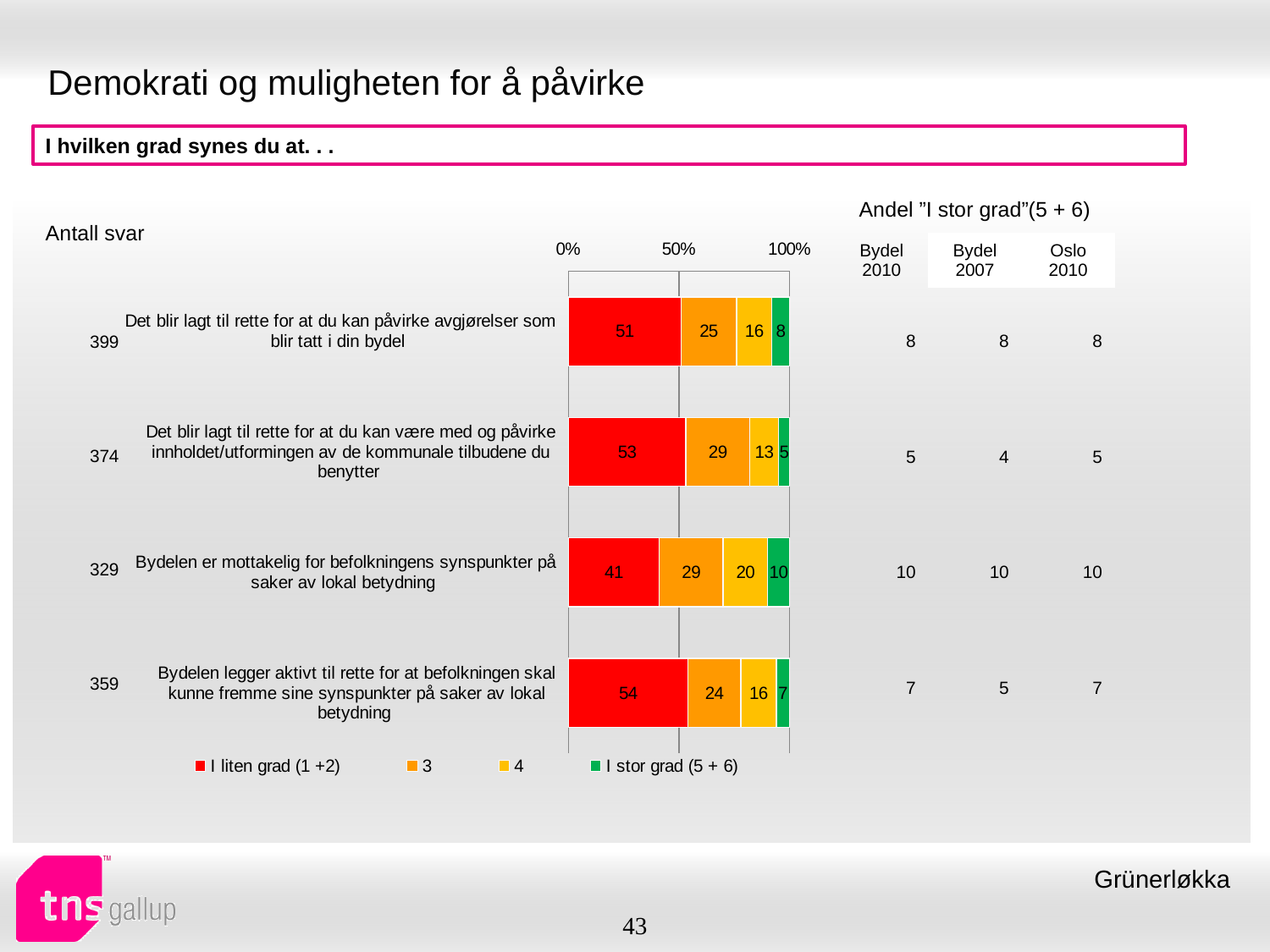
Which statement has the highest 'I liten grad (1 +2)' value? Bydelen legger aktivt til rette for at befolkningen skal kunne fremme sine synspunkter på saker av lokal betydning What is the value of 'I stor grad (5 + 6)' for 'Det blir lagt til rette for at du kan påvirke avgjørelser som blir tatt i din bydel'? 8 Which statement has the lowest 'I stor grad (5 + 6)' value? Det blir lagt til rette for at du kan være med og påvirke innholdet/utformingen av de kommunale tilbudene du benytter What is the difference between the 'I liten grad (1 +2)' values for 'Bydelen legger aktivt til rette for at befolkningen skal kunne fremme sine synspunkter på saker av lokal betydning' and 'Bydelen er mottakelig for befolkningens synspunkter på saker av lokal betydning'? 13 Which colour represents 'I stor grad (5 + 6)' in the chart? green How many statements (categories) are plotted in the chart? 4 Which is larger: the series '3' value for 'Det blir lagt til rette for at du kan påvirke avgjørelser som blir tatt i din bydel' or for 'Det blir lagt til rette for at du kan være med og påvirke innholdet/utformingen av de kommunale tilbudene du benytter'? Det blir lagt til rette for at du kan være med og påvirke innholdet/utformingen av de kommunale tilbudene du benytter What is the value of series '4' for 'Det blir lagt til rette for at du kan være med og påvirke innholdet/utformingen av de kommunale tilbudene du benytter'? 13 How many series does the chart legend list? 4 What is the value of 'I liten grad (1 +2)' for 'Bydelen er mottakelig for befolkningens synspunkter på saker av lokal betydning'? 41 What kind of chart is shown on the slide? stacked bar chart What is the total of the stacked bar for 'Bydelen er mottakelig for befolkningens synspunkter på saker av lokal betydning'? 100